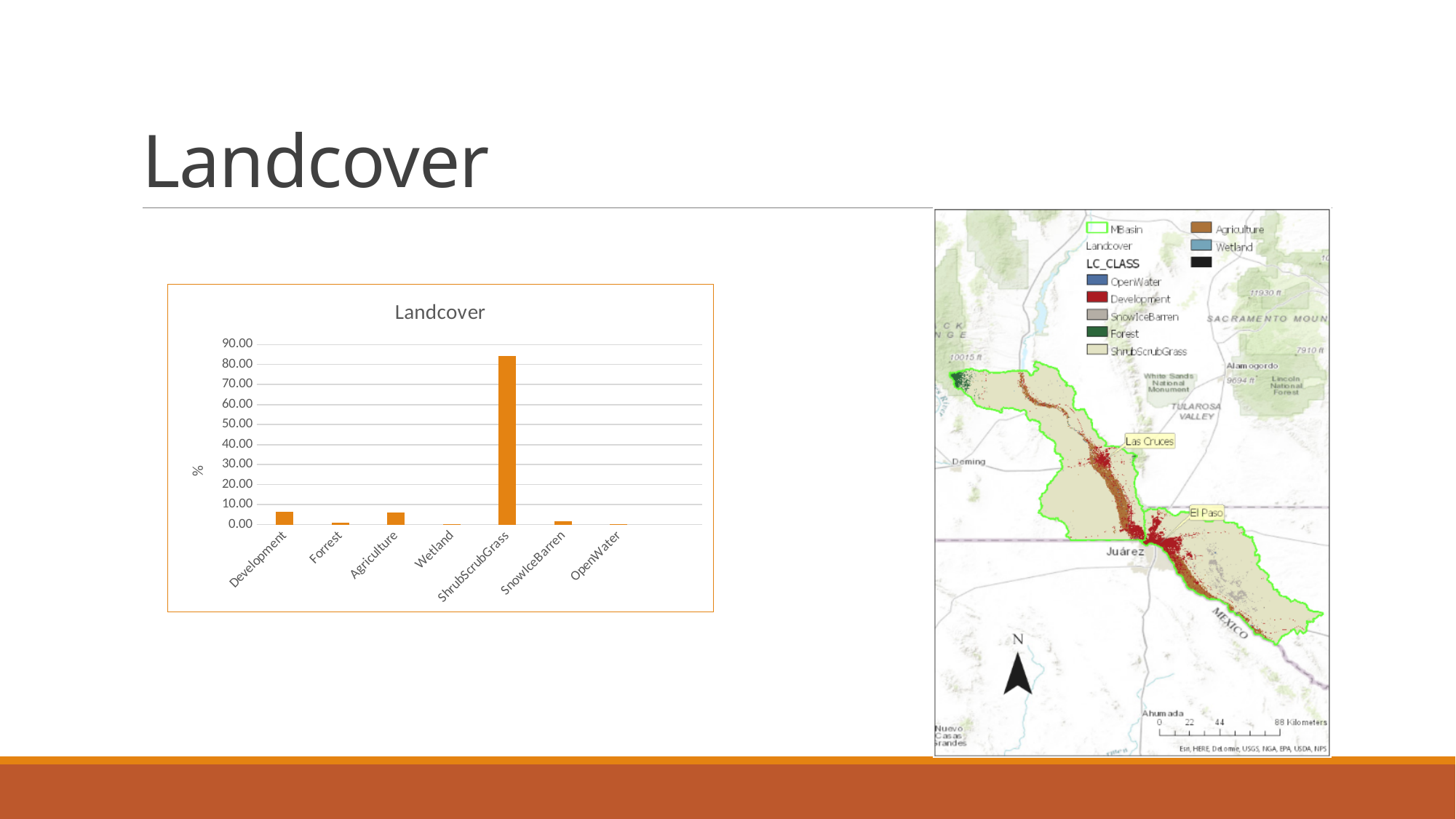
Which is larger, the value for Development or the value for Forrest? Development Is the value for ShrubScrubGrass greater or less than 90.00? less What is the label on the vertical axis of the Landcover chart? % Is the value for Agriculture greater or less than 10.00? less What kind of chart is the Landcover chart? bar chart Which is larger, the value for Agriculture or the value for SnowIceBarren? Agriculture How many landcover categories are shown on the x axis of the Landcover chart? 7 Which category has the highest value in the Landcover chart? ShrubScrubGrass Is the value for ShrubScrubGrass greater or less than 80.00? greater Which is larger, the value for ShrubScrubGrass or the value for Development? ShrubScrubGrass What is the title of the chart on the slide? Landcover